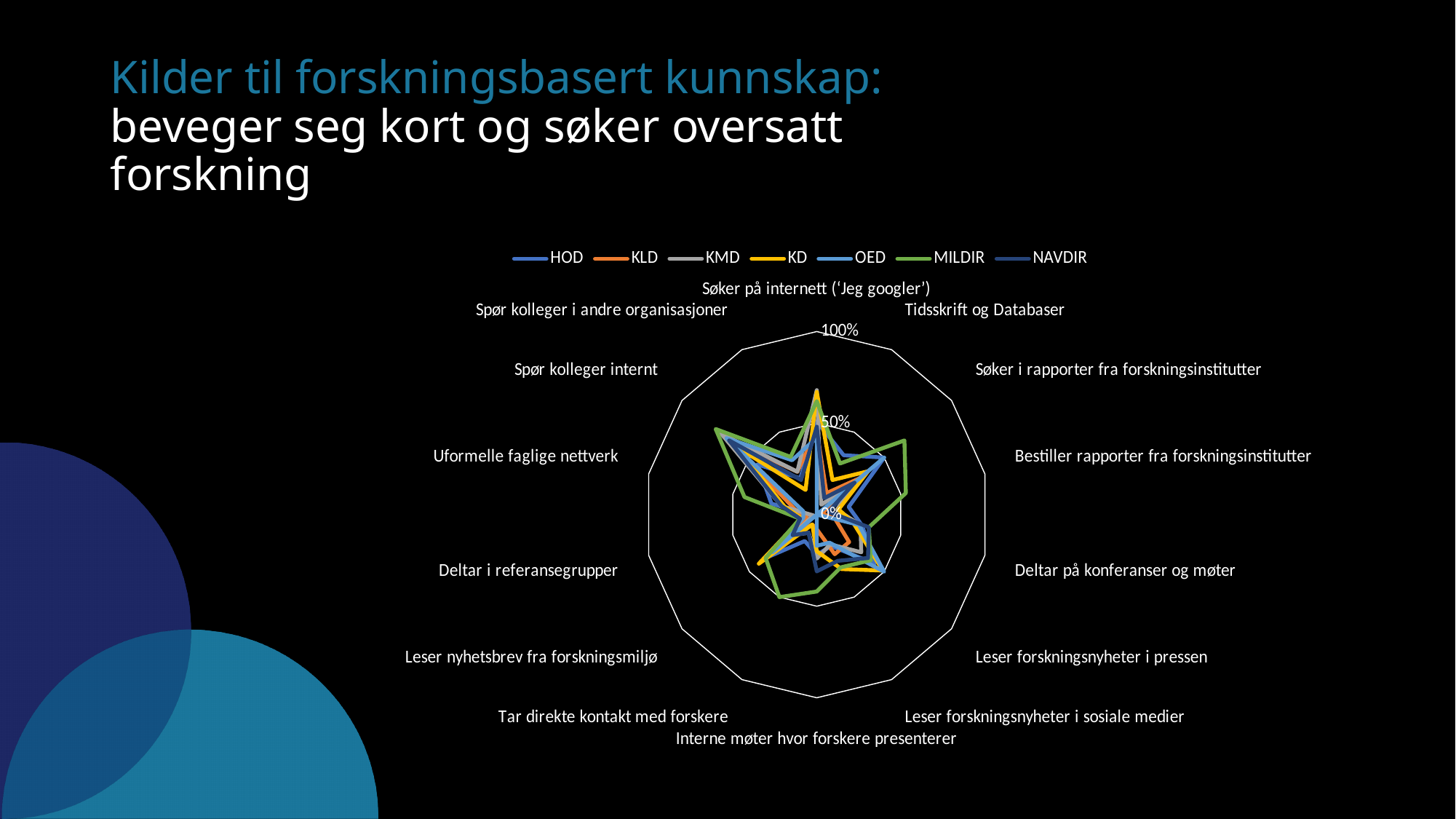
Is the value for KLD for 'Leser forskningsnyheter i sosiale medier' greater or less than 50%? less Is the value for MILDIR for 'Spør kolleger internt' greater or less than 50%? greater What kind of chart is shown on the slide? Radar chart What is the highest percentage tick shown on the radar chart's axis? 100% How many categories (axes) does the radar chart have? 14 How many series does the legend of the radar chart list? 7 Is the value for MILDIR for 'Søker på internett (‘Jeg googler’)' greater or less than 100%? less Which series is drawn in green in the radar chart? MILDIR